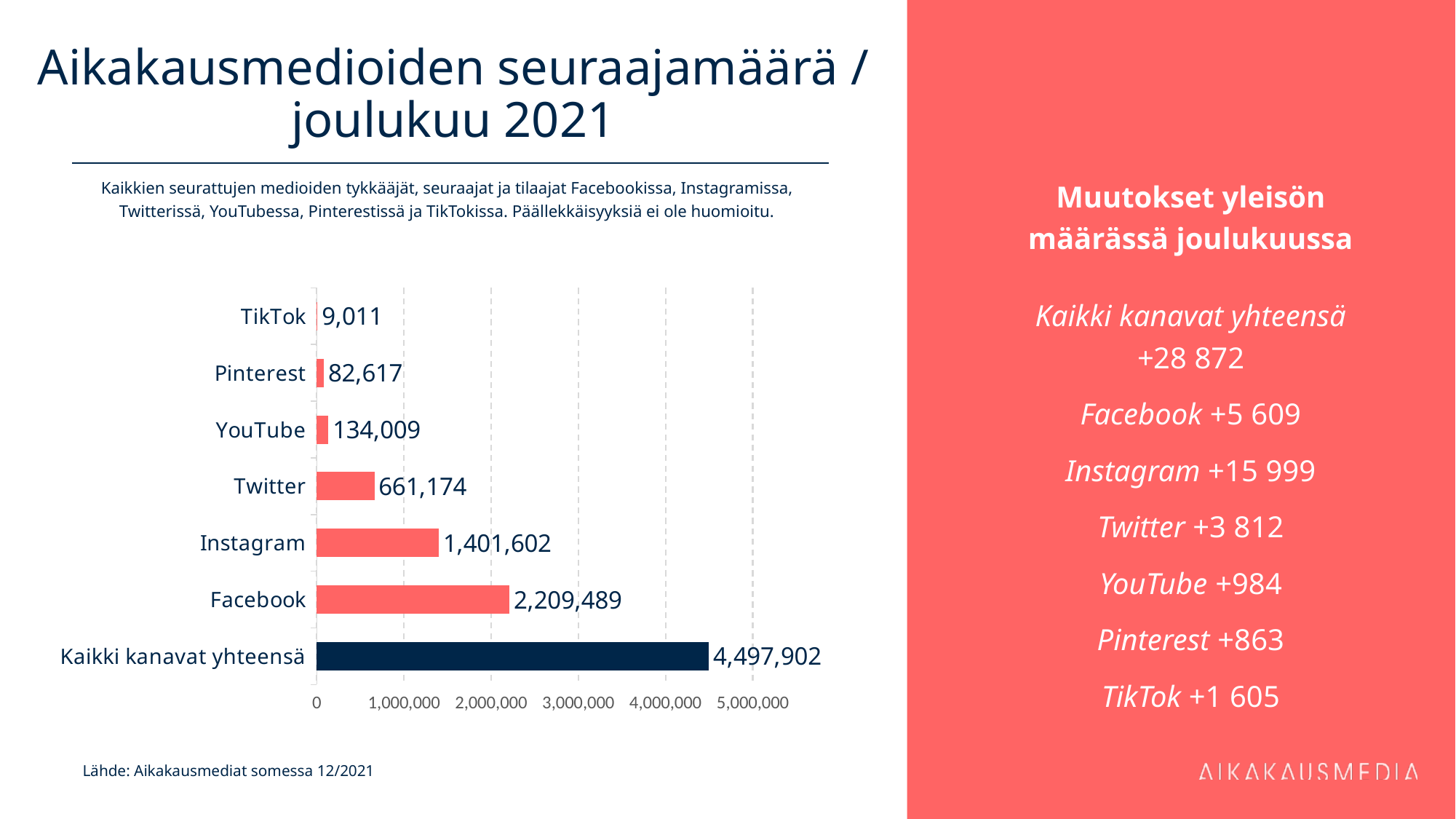
Is the value for Facebook greater or less than 2,000,000? greater What is the number of followers shown for Facebook? 2,209,489 What type of chart is shown on the slide? Bar chart Which has a larger value, Twitter or YouTube? Twitter What is the value shown for TikTok? 9,011 What is the difference between the Twitter and YouTube values? 527,165 What value is shown for Instagram in the bar chart? 1,401,602 What is the difference between the Facebook and Instagram values? 807,887 How many bars are shown in the chart? 7 Which category has the lowest value in the chart? TikTok Which individual channel (excluding the total bar) has the highest value? Facebook What is the value of the 'Kaikki kanavat yhteensä' bar? 4,497,902